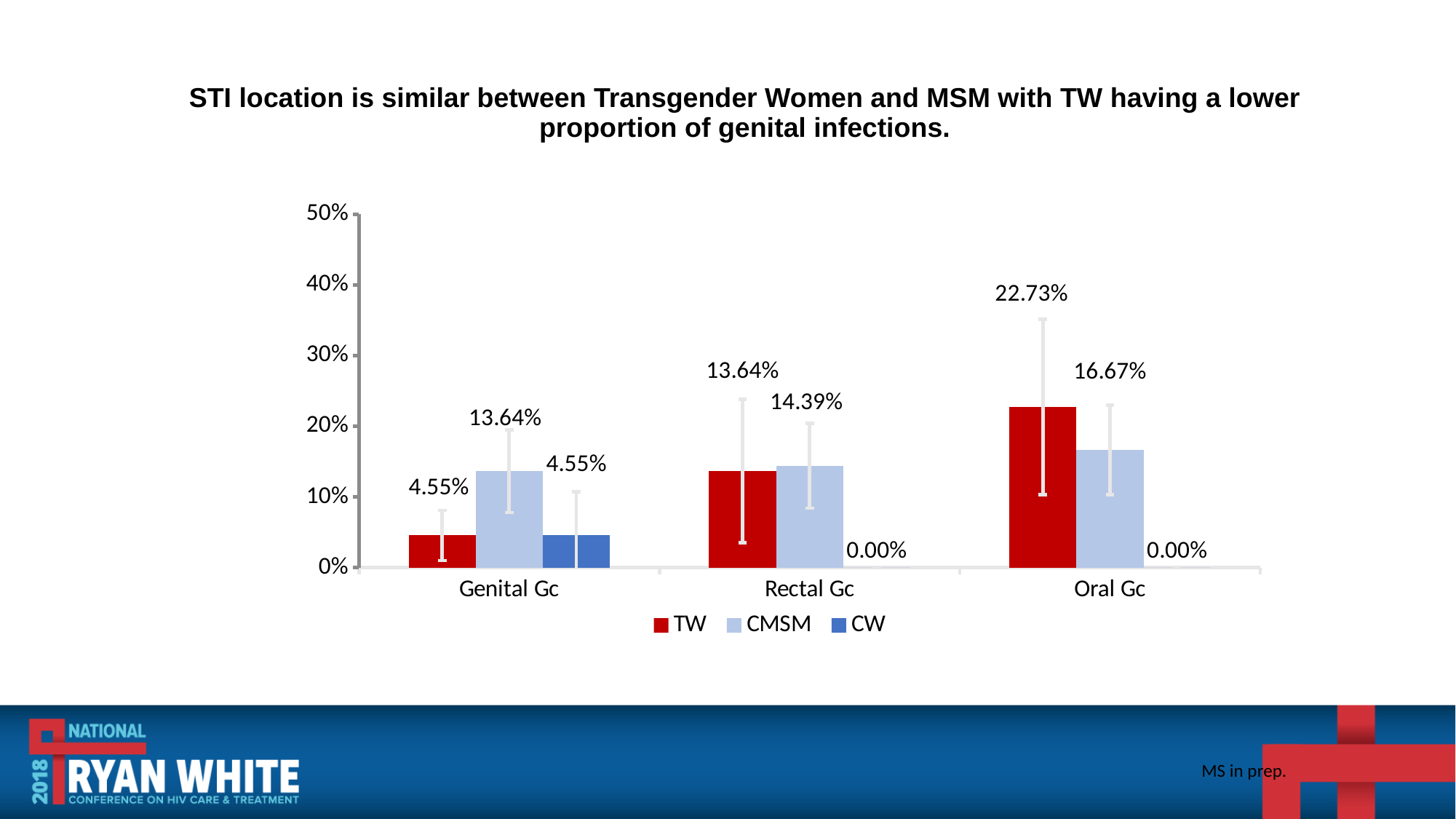
What is the value for TW in the Genital Gc category? 4.55% Is the value for TW in the Oral Gc category greater or less than 20%? greater What is the value for CMSM in the Rectal Gc category? 14.39% What is the difference between the TW and CMSM values in the Oral Gc category? 6.06% How many categories are shown on the x axis? 3 Which is larger in the Genital Gc category, the TW value or the CMSM value? CMSM What is the value for TW in the Oral Gc category? 22.73% How many series does the legend list? 3 In which category does the TW series have its highest value? Oral Gc What is the value for CW in the Oral Gc category? 0.00% In which category does the CMSM series have its lowest value? Genital Gc What kind of chart is shown on the slide? Bar chart